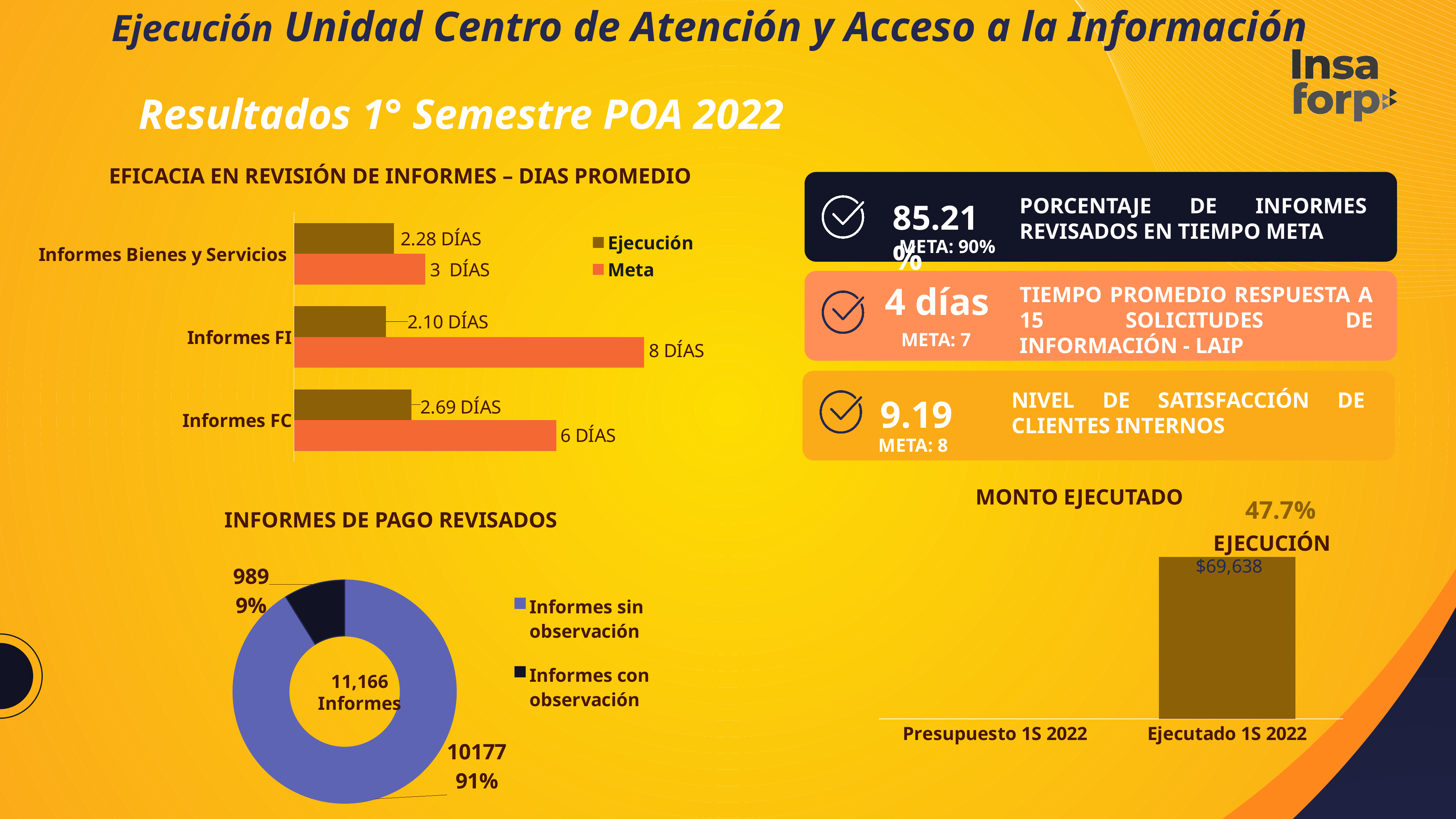
In the 'EFICACIA EN REVISIÓN DE INFORMES – DIAS PROMEDIO' chart, what is the Meta value for Informes FC? 6 DÍAS In the 'INFORMES DE PAGO REVISADOS' chart, what share of the total is Informes sin observación? 91% In the 'EFICACIA EN REVISIÓN DE INFORMES – DIAS PROMEDIO' chart, how many categories are shown? 3 In the 'EFICACIA EN REVISIÓN DE INFORMES – DIAS PROMEDIO' chart, what is the difference between the Meta and Ejecución values for Informes Bienes y Servicios? 0.72 DÍAS In the 'MONTO EJECUTADO' chart, what is the value for Ejecutado 1S 2022? $69,638 What kind of chart is 'INFORMES DE PAGO REVISADOS'? Doughnut chart In the 'EFICACIA EN REVISIÓN DE INFORMES – DIAS PROMEDIO' chart, what is the Ejecución value for Informes FI? 2.10 DÍAS In the 'EFICACIA EN REVISIÓN DE INFORMES – DIAS PROMEDIO' chart, which category has the highest Meta value? Informes FI In the 'EFICACIA EN REVISIÓN DE INFORMES – DIAS PROMEDIO' chart, which category has the lowest Ejecución value? Informes FI In the 'EFICACIA EN REVISIÓN DE INFORMES – DIAS PROMEDIO' chart, how many series does the legend list? 2 In the 'INFORMES DE PAGO REVISADOS' chart, what is the value for Informes con observación? 989 In the 'INFORMES DE PAGO REVISADOS' chart, what total number of informes is shown in the centre? 11,166 Informes